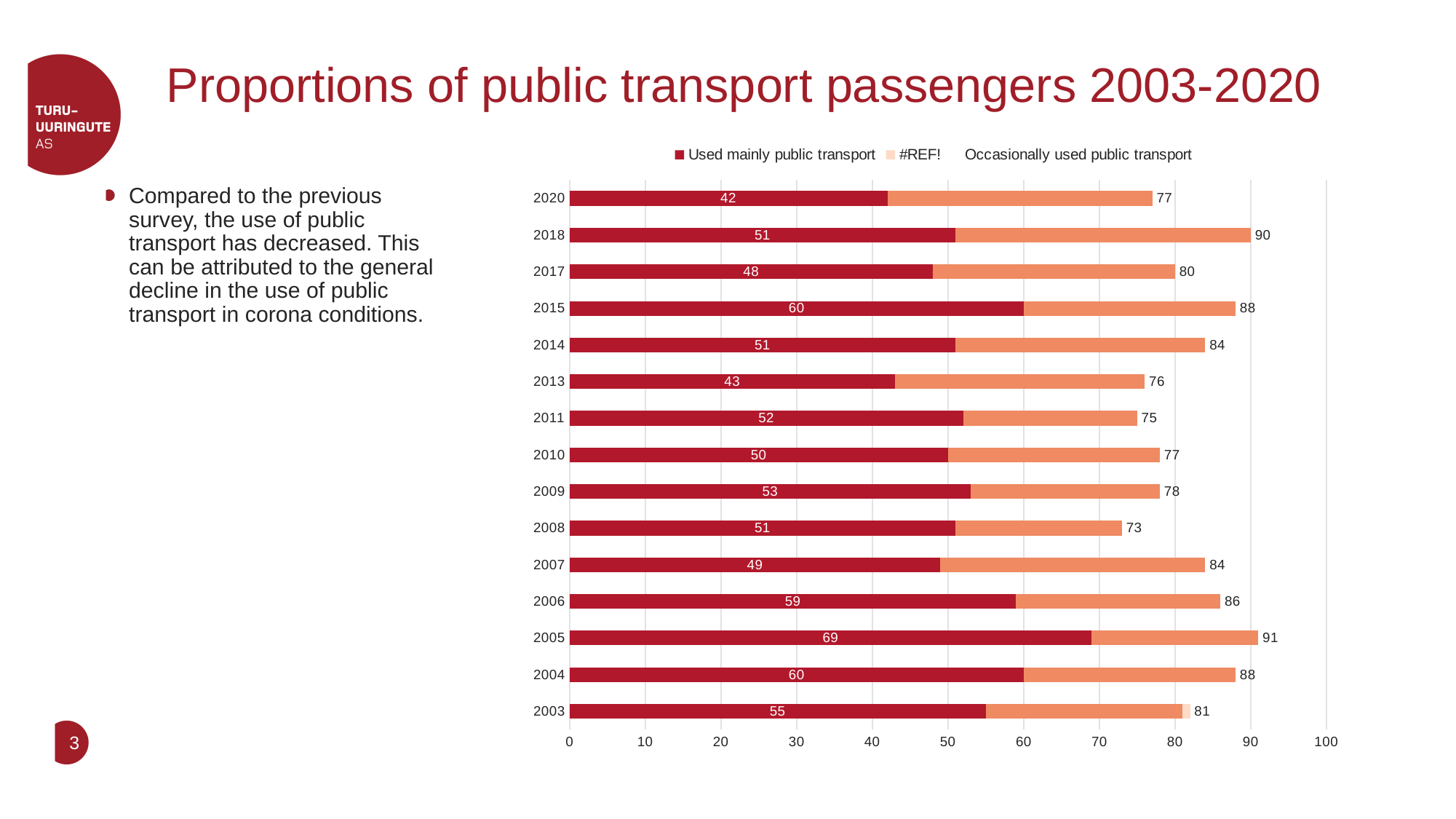
Which year has the lowest value for "Used mainly public transport"? 2020 Which year has the larger "Used mainly public transport" value, 2015 or 2017? 2015 What is the difference between the "Used mainly public transport" values for 2018 and 2020? 9 What is the value for "Used mainly public transport" in 2020? 42 What kind of chart is shown on the slide? Stacked bar chart What is the total value printed at the end of the 2003 bar? 81 Which year has the highest value for "Used mainly public transport"? 2005 What is the total value printed at the end of the 2018 bar? 90 What is the value for "Used mainly public transport" in 2005? 69 Which legend entry shows an error label instead of a series name? #REF! How many years are shown on the chart? 15 How many series does the legend list? 3